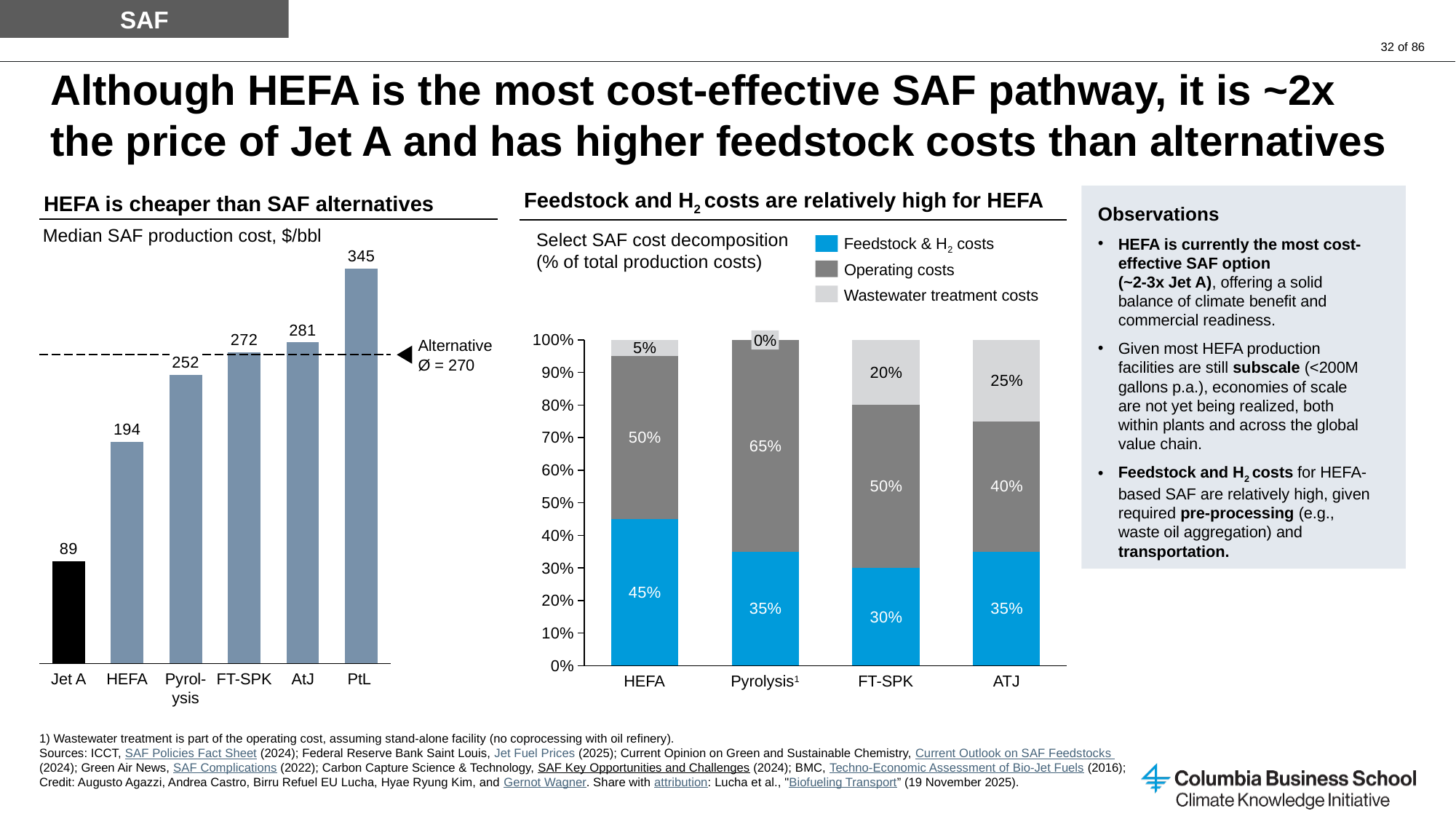
In the 'HEFA is cheaper than SAF alternatives' chart, what is the value of the dashed 'Alternative Ø' line? 270 In the 'Feedstock and H2 costs are relatively high for HEFA' chart, is the Feedstock & H2 costs share larger for HEFA or for FT-SPK? HEFA In the 'Feedstock and H2 costs are relatively high for HEFA' chart, what share of HEFA's total production cost is Feedstock & H2 costs? 45% In the 'Feedstock and H2 costs are relatively high for HEFA' chart, what is the Operating costs share for Pyrolysis? 65% What kind of chart is 'Feedstock and H2 costs are relatively high for HEFA'? Stacked bar chart In the 'HEFA is cheaper than SAF alternatives' chart, which category has the highest median production cost? PtL In the 'Feedstock and H2 costs are relatively high for HEFA' chart, which pathway has the highest Wastewater treatment costs share? ATJ In the 'HEFA is cheaper than SAF alternatives' chart, what is the difference between the PtL and Jet A values? 256 In the 'Feedstock and H2 costs are relatively high for HEFA' chart, how many series does the legend list? 3 In the 'HEFA is cheaper than SAF alternatives' chart, which category has the lowest median production cost? Jet A In the 'HEFA is cheaper than SAF alternatives' chart, how many categories are shown? 6 In the 'HEFA is cheaper than SAF alternatives' chart, what is the median production cost for HEFA? 194